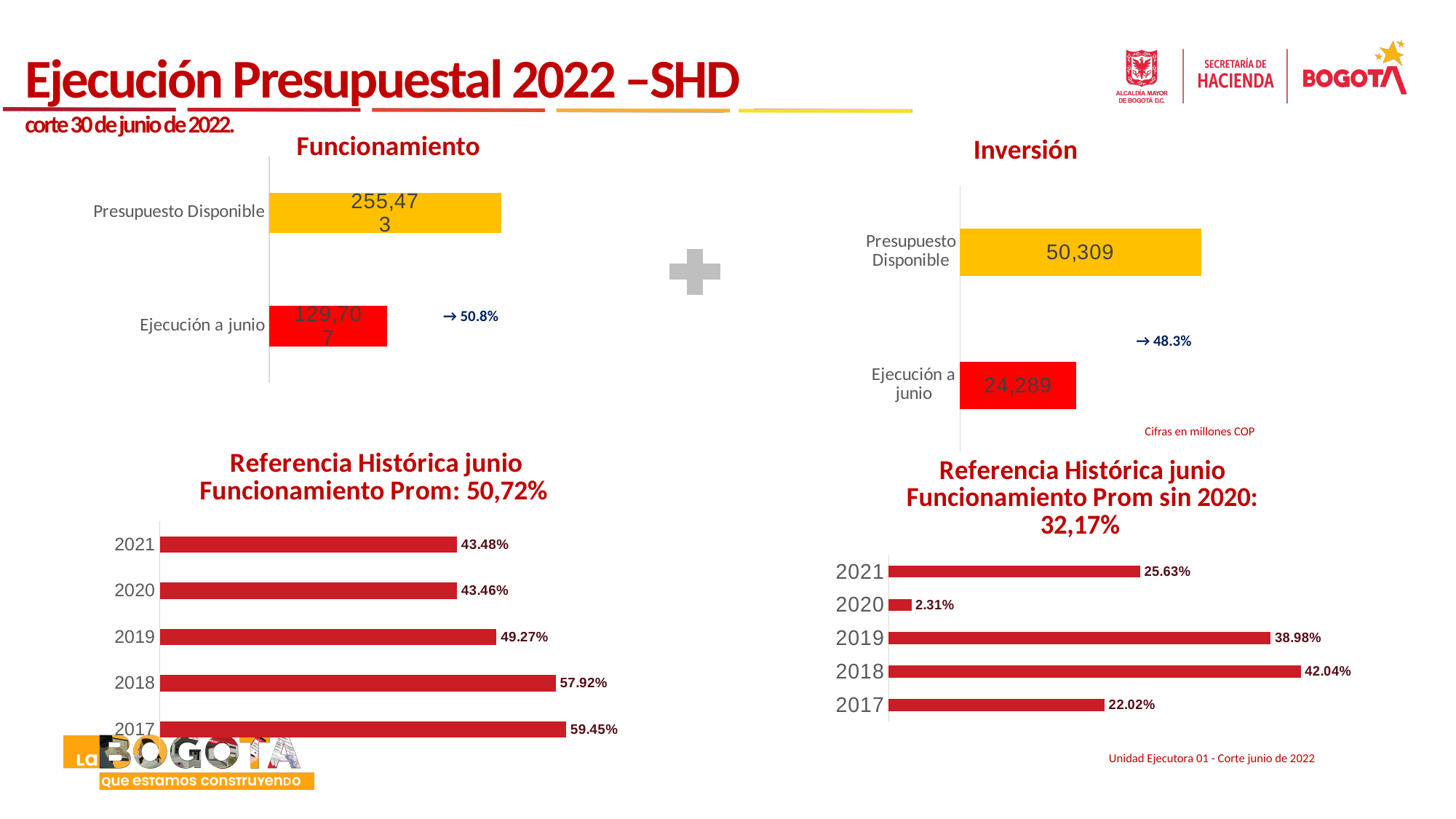
In the Funcionamiento chart (top left), what is the value for Presupuesto Disponible? 255,473 In the bottom-left chart titled 'Referencia Histórica junio Funcionamiento Prom: 50,72%', which year has the highest value? 2017 In the Inversión chart (top right), what is the difference between Presupuesto Disponible and Ejecución a junio? 26,020 In the bottom-left chart titled 'Referencia Histórica junio Funcionamiento Prom: 50,72%', what is the value for 2019? 49.27% In the Inversión chart (top right), what is the value for Presupuesto Disponible? 50,309 How many years are shown in the bottom-right chart titled 'Referencia Histórica junio Funcionamiento Prom sin 2020: 32,17%'? 5 In the bottom-left chart titled 'Referencia Histórica junio Funcionamiento Prom: 50,72%', what is the difference between 2017 and 2018? 1.53% In the bottom-right chart titled 'Referencia Histórica junio Funcionamiento Prom sin 2020: 32,17%', what is the value for 2018? 42.04% In the bottom-right chart titled 'Referencia Histórica junio Funcionamiento Prom sin 2020: 32,17%', which year has the lowest value? 2020 What kind of chart is the Inversión chart (top right)? Bar chart In the Inversión chart (top right), which is larger, Presupuesto Disponible or Ejecución a junio? Presupuesto Disponible In the Funcionamiento chart (top left), what is the value for Ejecución a junio? 129,707